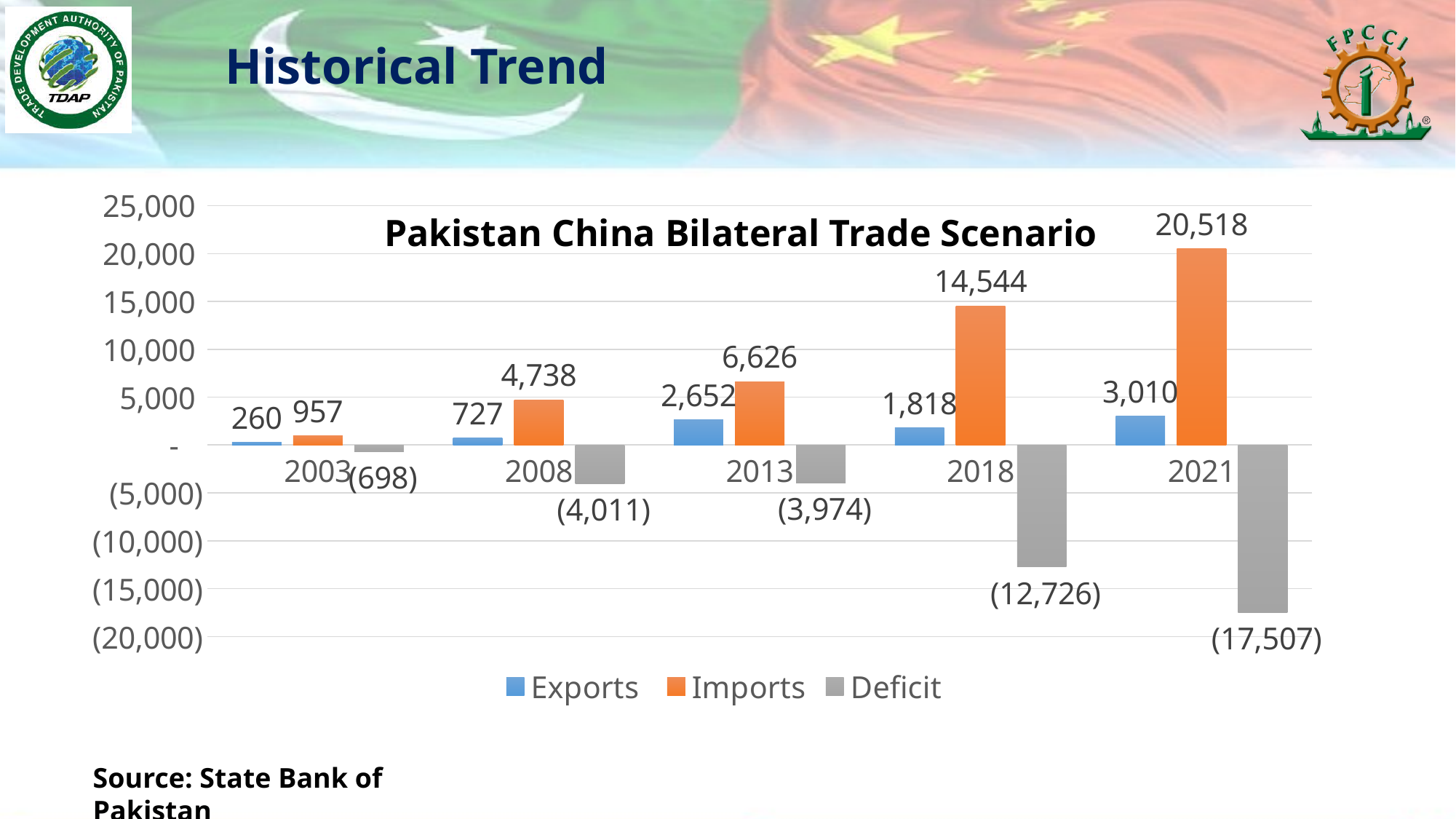
What is the value of Imports in 2021? 20,518 What is the Deficit value shown for 2018? (12,726) What is the value of Exports in 2013? 2,652 Do Imports rise or fall from 2003 to 2021? rise What is the difference between Imports and Exports in 2018? 12,726 In which year are Imports highest? 2021 Which is larger in 2008: Exports or Imports? Imports What kind of chart is shown? bar chart Is the value for Imports in 2013 greater or less than 5,000? greater In which year are Exports lowest? 2003 How many series does the legend list? 3 How many years are shown on the x axis? 5